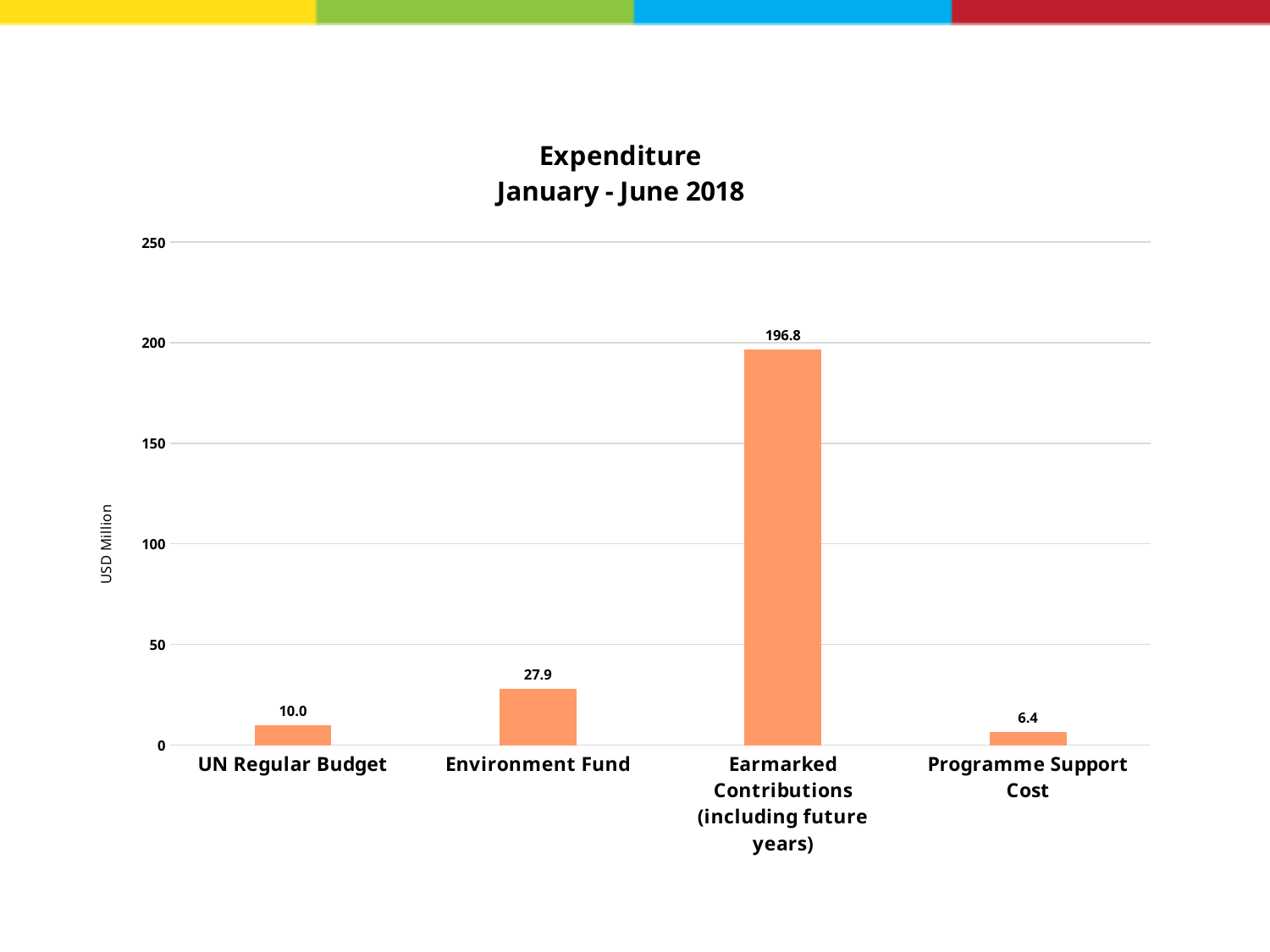
Is the value for Earmarked Contributions (including future years) greater or less than 150? greater What is the difference between the Environment Fund and UN Regular Budget values? 17.9 What is the expenditure value for Programme Support Cost? 6.4 Which category has the lowest expenditure? Programme Support Cost Which category has the highest expenditure? Earmarked Contributions (including future years) What is the expenditure value for Earmarked Contributions (including future years)? 196.8 What unit is shown on the vertical axis label? USD Million What is the expenditure value for Environment Fund? 27.9 Which is larger, the value for UN Regular Budget or the value for Programme Support Cost? UN Regular Budget How many categories are shown on the x axis? 4 What kind of chart is shown on the slide? Bar chart What is the expenditure value for UN Regular Budget? 10.0